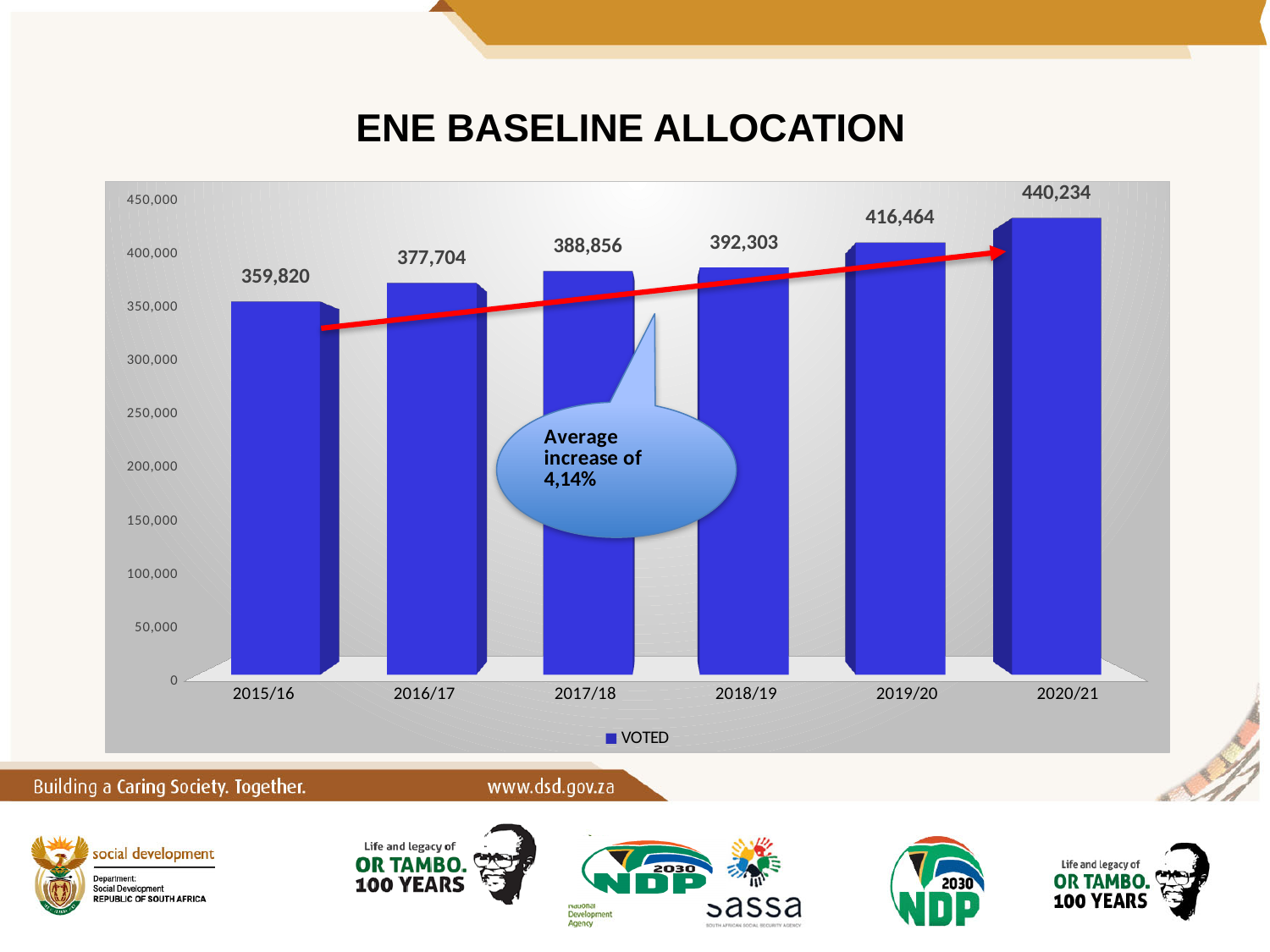
What is the difference between the VOTED values for 2020/21 and 2019/20? 23,770 What kind of chart is shown on the slide? Bar chart How many years are shown on the x axis? 6 Which year has the lowest VOTED value? 2015/16 What is the VOTED value for 2020/21? 440,234 What is the difference between the VOTED values for 2016/17 and 2015/16? 17,884 Which is larger, the VOTED value for 2017/18 or for 2019/20? 2019/20 Is the VOTED value for 2019/20 greater or less than 400,000? greater What is the VOTED value for 2018/19? 392,303 Do the VOTED values rise or fall from 2015/16 to 2020/21? Rise Which year has the highest VOTED value? 2020/21 What is the VOTED value for 2015/16? 359,820